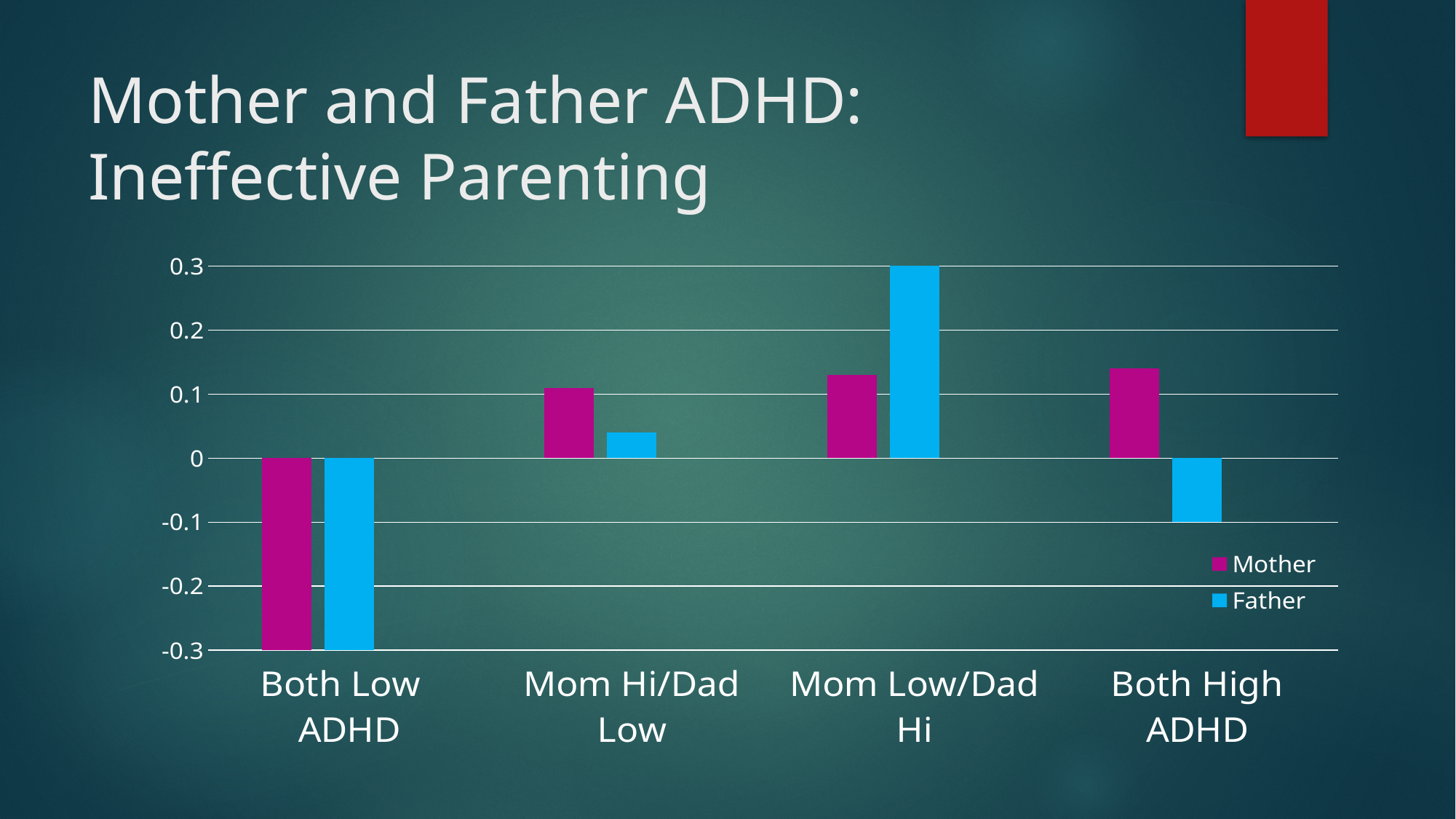
How many categories are shown on the x axis? 4 Is the Mother value for Both Low ADHD greater or less than -0.2? less What kind of chart is shown on the slide? bar chart How many series does the legend list? 2 For Mom Low/Dad Hi, which is larger, the Mother value or the Father value? Father Which category has the highest Father value? Mom Low/Dad Hi Which category has the lowest Father value? Both Low ADHD For Mom Hi/Dad Low, which is larger, the Mother value or the Father value? Mother What colour represents the Father series in the legend? blue What is the Father value for Both High ADHD? -0.1 Is the Mother value for Mom Hi/Dad Low greater or less than 0.2? less